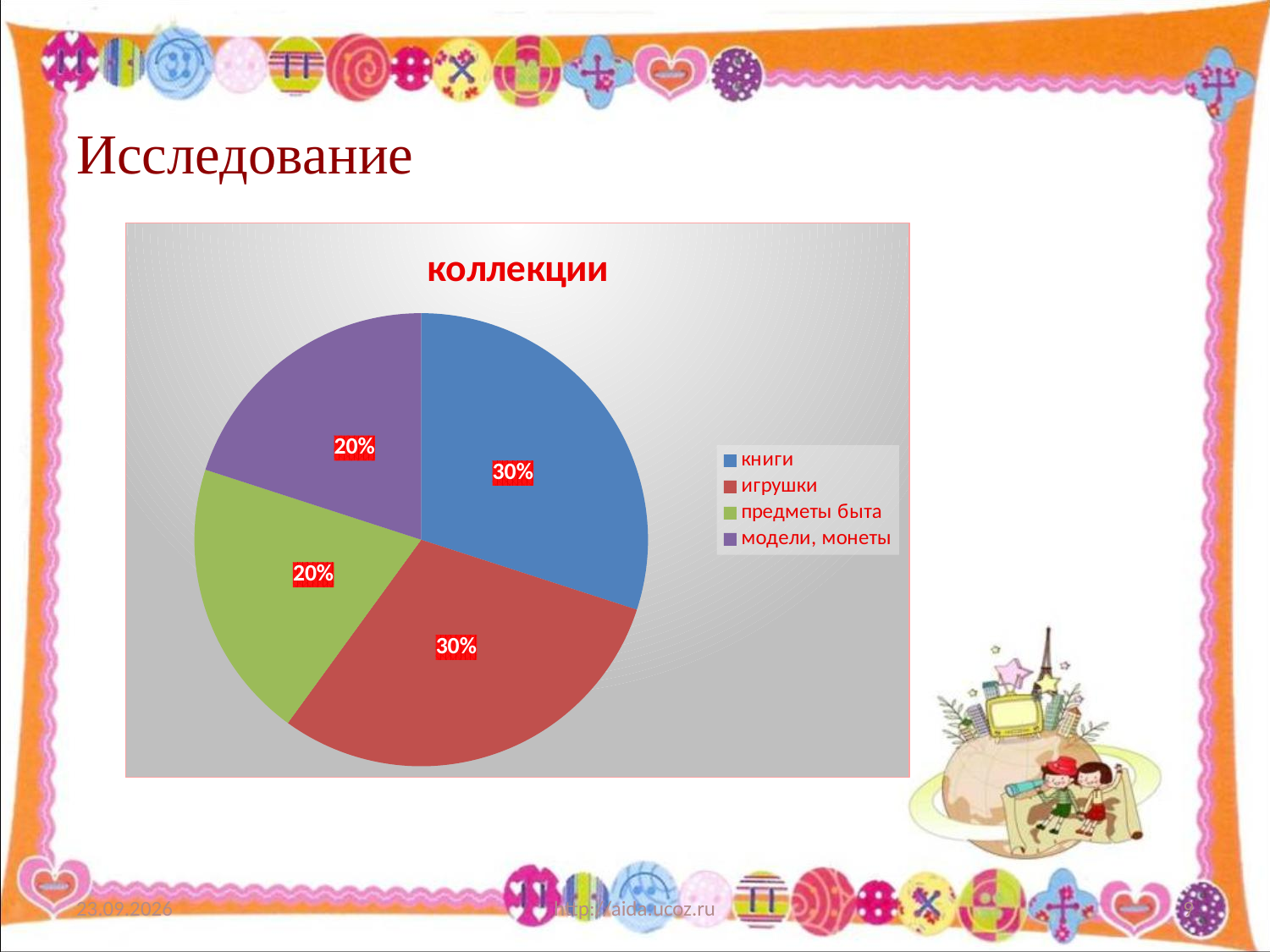
Which is larger, the slice for модели, монеты or the slice for игрушки? игрушки What share of the pie does the slice for книги represent? 30% What colour is the slice for предметы быта? green What share of the pie does the slice for игрушки represent? 30% What type of chart is shown on the slide? pie chart What is the difference between the share for игрушки and the share for модели, монеты? 10% How many entries does the legend list? 4 Which is larger, the slice for книги or the slice for предметы быта? книги What share of the pie does the slice for предметы быта represent? 20% How many slices does the pie chart have? 4 What is the title of the chart? коллекции